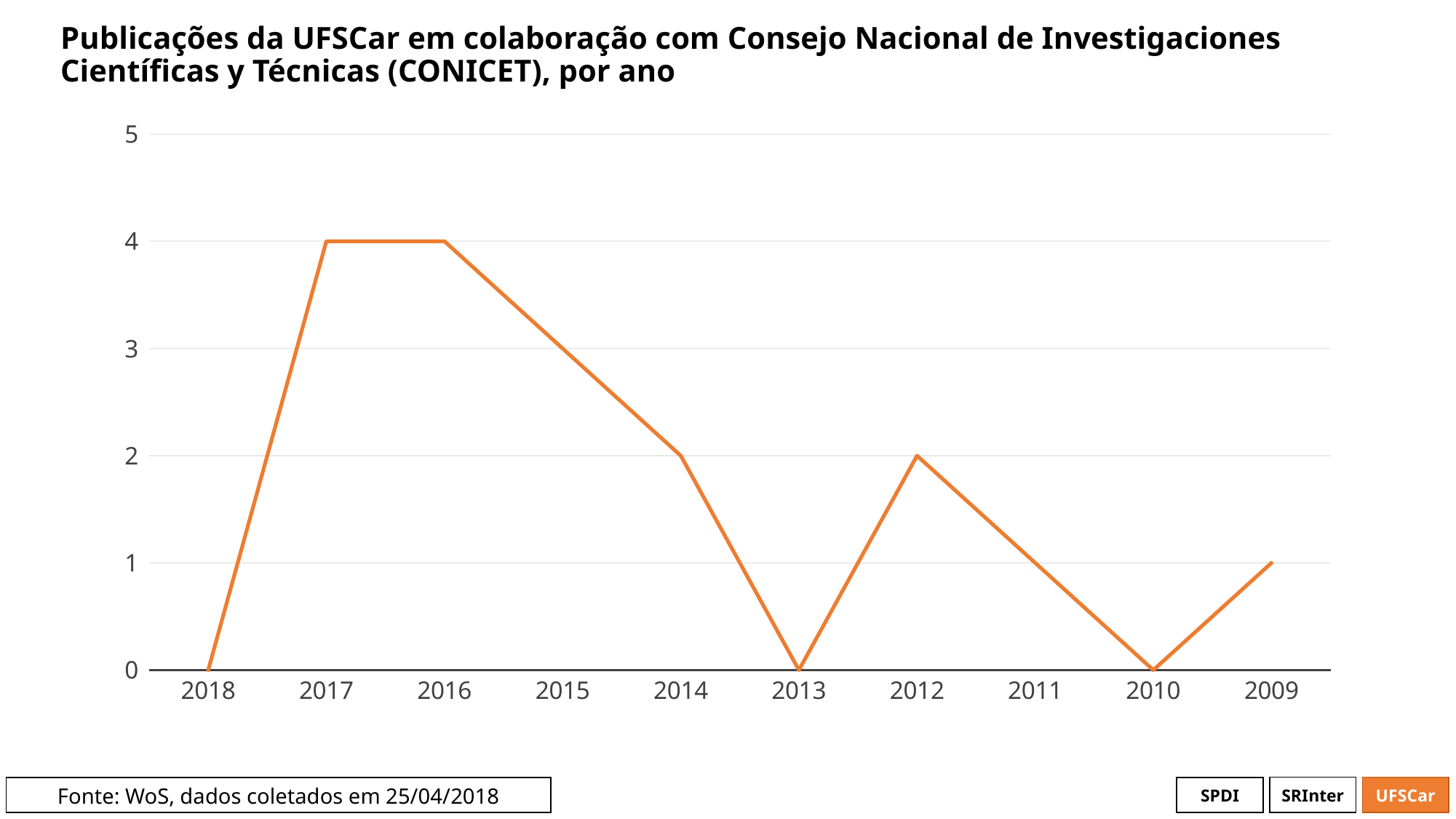
What is the value for 2009? 1 What is the highest value shown on the y axis of the chart? 5 Which years have the highest value on the chart? 2017 and 2016 Is the value for 2015 greater or less than 2? greater What is the value for 2017? 4 Which years have a value of 0 on the chart? 2018, 2013 and 2010 What kind of chart is shown on the slide? line chart What is the value for 2018? 0 What is the value for 2014? 2 How many years are shown on the x axis of the chart? 10 Which is larger, the value for 2012 or the value for 2009? 2012 What is the difference between the values for 2016 and 2014? 2